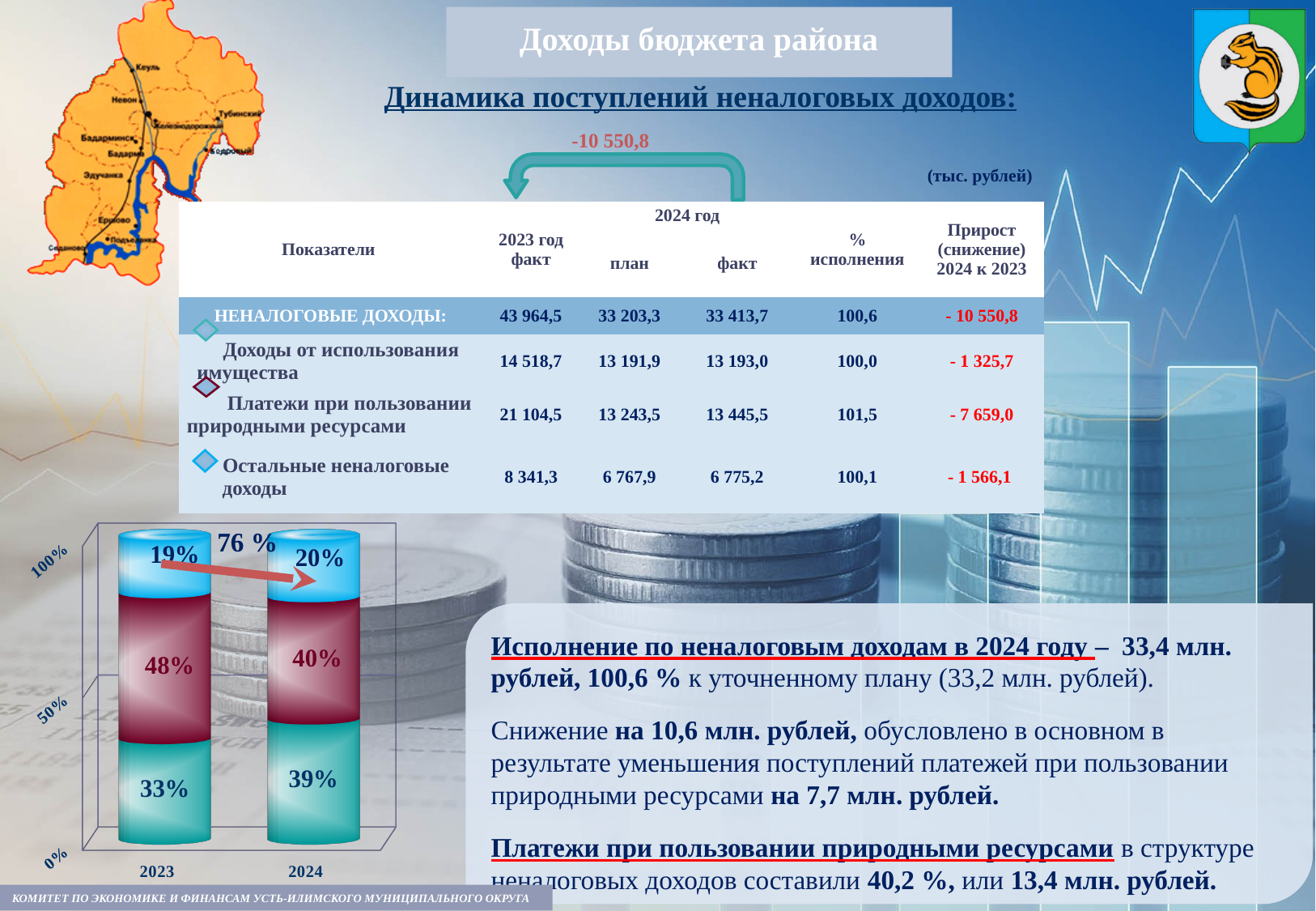
In the stacked bar chart, what is the value of the bottom (teal) segment for 2024? 39% In the stacked bar chart, which segment is the smallest in the 2023 bar? The top (light blue) segment, 19% In the stacked bar chart, what is the value of the middle (dark red) segment for 2023? 48% How many segments does each bar in the stacked bar chart contain? 3 In the stacked bar chart, what is the value of the top (light blue) segment for 2024? 20% In the stacked bar chart, does the middle (dark red) segment rise or fall from 2023 to 2024? Fall What kind of chart is shown in the lower-left of the slide? Stacked bar chart In the stacked bar chart, which segment is the largest in the 2024 bar? The middle (dark red) segment, 40% In the stacked bar chart, what is the value of the top (light blue) segment for 2023? 19% How many categories (years) are shown on the x axis of the stacked bar chart? 2 In the stacked bar chart, which year has the larger bottom (teal) segment, 2023 or 2024? 2024 In the stacked bar chart, by how many percentage points does the middle (dark red) segment differ between 2023 and 2024? 8